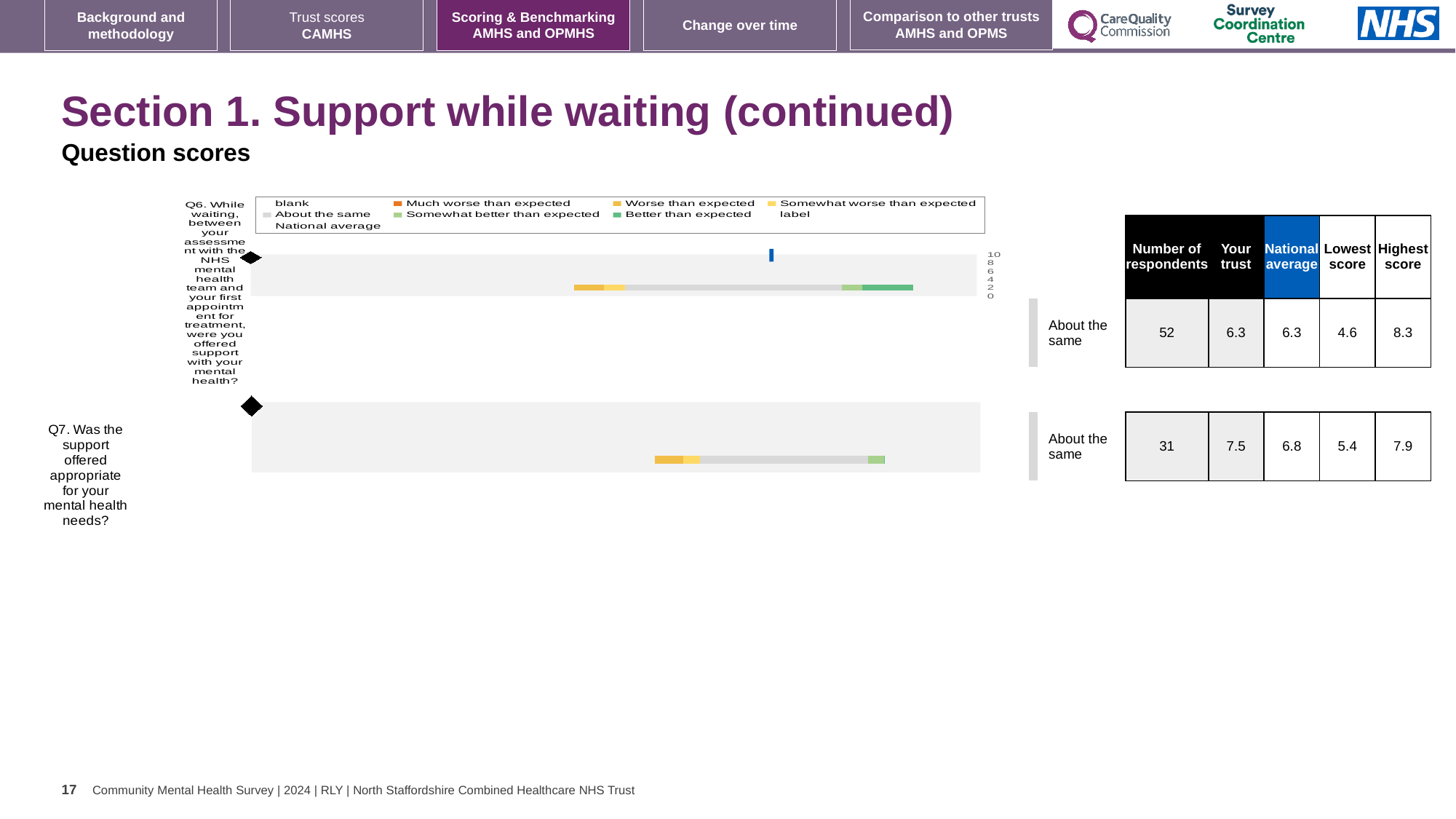
What kind of chart is used to show the question scores for Q6 and Q7? bar chart For Q7, what is the difference between the 'Your trust' score and the national average? 0.7 For Q7, is the 'Your trust' score or the national average larger? Your trust For Q7, what is the 'Your trust' score? 7.5 For Q7, what is the highest score shown? 7.9 What colour does the legend use for 'Better than expected'? green What benchmark category is shown for Q7 next to its chart? About the same For Q6, what is the 'Your trust' score? 6.3 For Q6, what is the national average score? 6.3 For Q6, what is the difference between the highest score and the lowest score? 3.7 How many questions (Q6 and Q7) are plotted on the slide? 2 For Q6, how many respondents are shown in the table next to the chart? 52